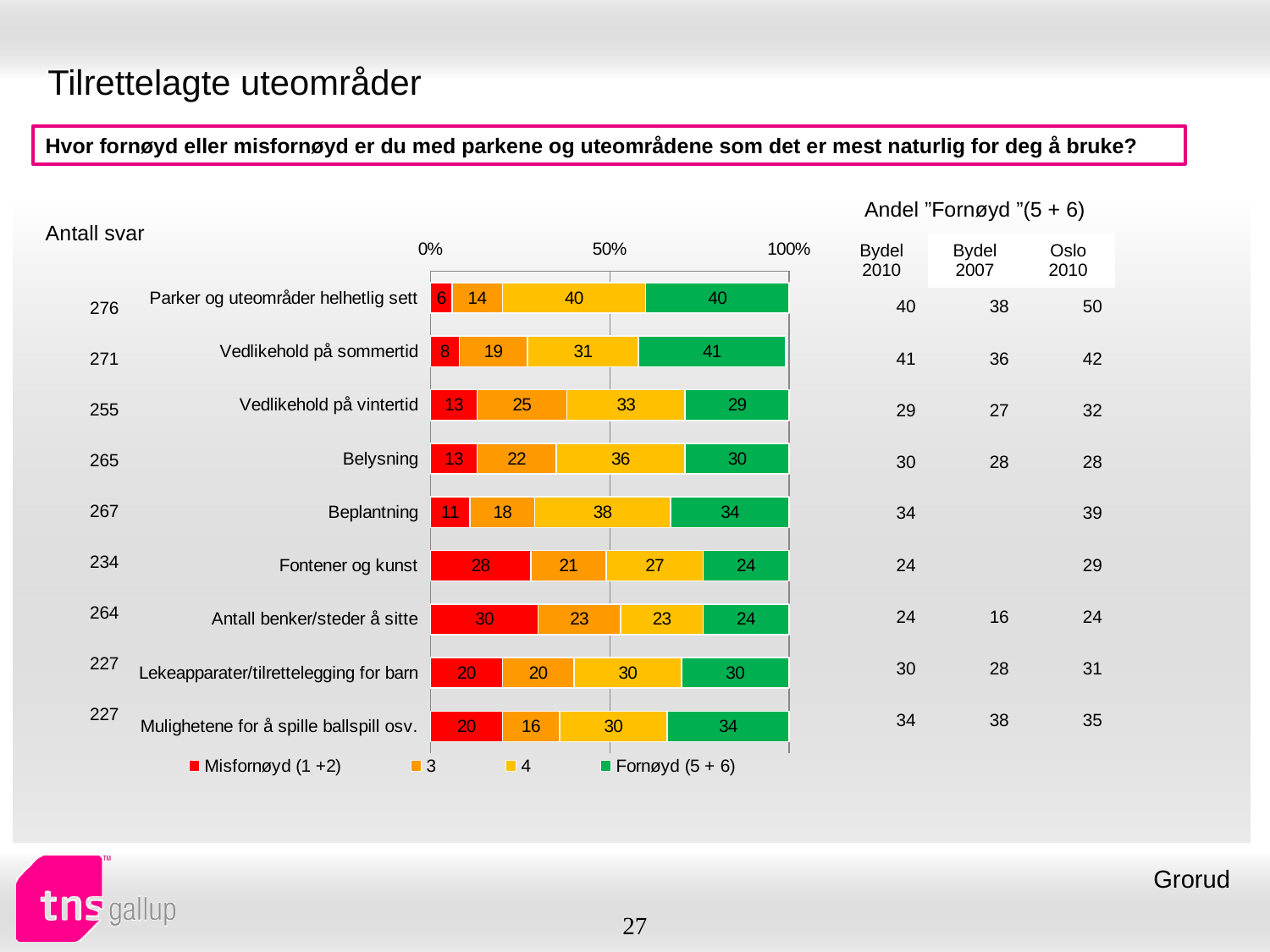
What is the value of series "4" for "Beplantning"? 38 What is the difference between the "Fornøyd (5 + 6)" values for "Parker og uteområder helhetlig sett" and "Vedlikehold på vintertid"? 11 Which category has the highest "Fornøyd (5 + 6)" value? Vedlikehold på sommertid What is the value of "Fornøyd (5 + 6)" for "Vedlikehold på sommertid"? 41 What is the value of "Misfornøyd (1 +2)" for "Antall benker/steder å sitte"? 30 Which has the larger "Misfornøyd (1 +2)" value: "Fontener og kunst" or "Antall benker/steder å sitte"? Antall benker/steder å sitte What kind of chart is shown on the slide? Stacked bar chart Which category has the lowest "Misfornøyd (1 +2)" value? Parker og uteområder helhetlig sett How many series does the legend list? 4 What colour represents "Fornøyd (5 + 6)" in the chart? Green What is the total of the stacked bar for "Parker og uteområder helhetlig sett"? 100 How many categories are shown in the chart? 9